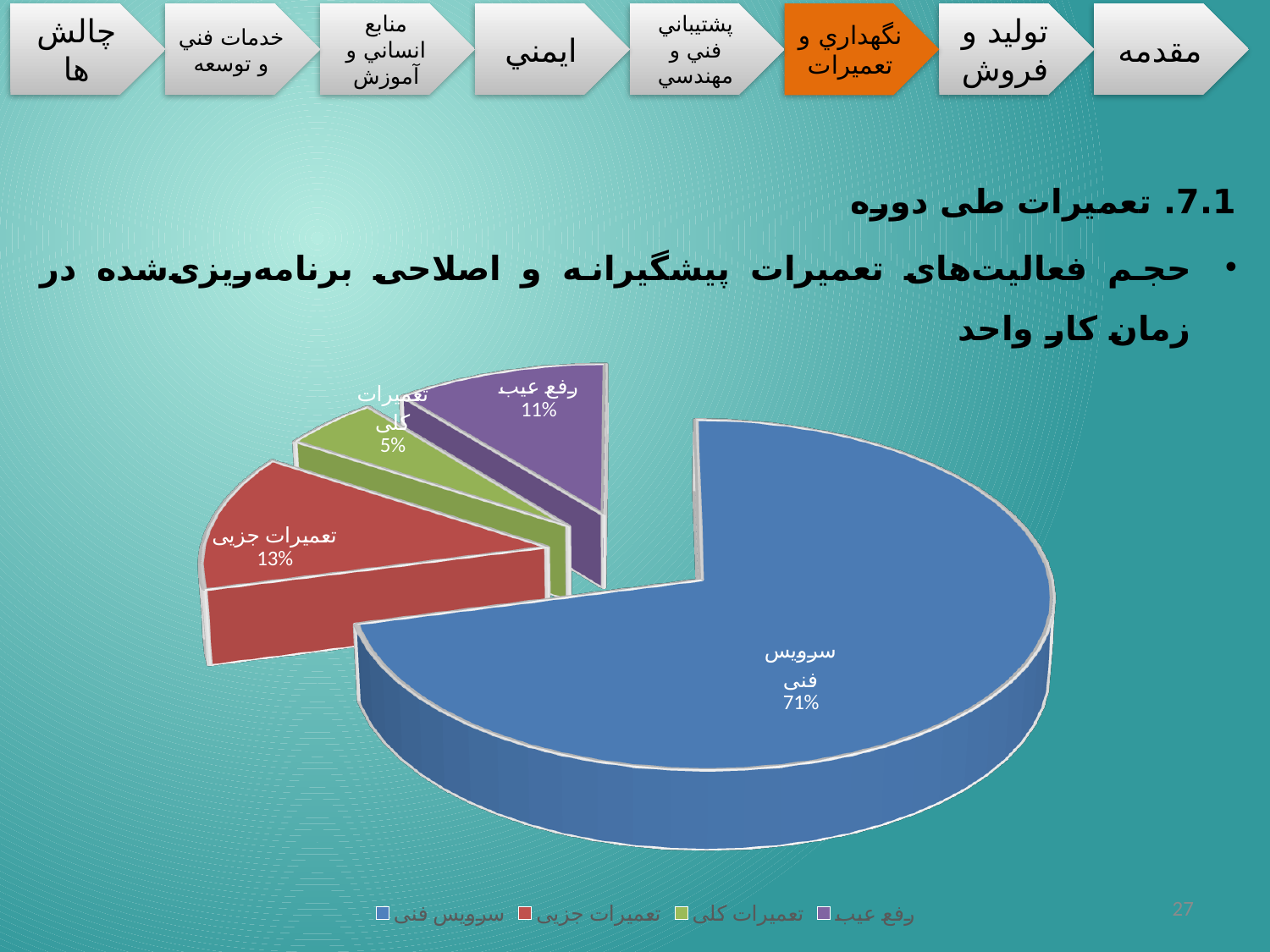
What share of the pie does تعمیرات کلی have? 5% What colour is the slice for رفع عیب? purple Which slice of the pie is the largest? سرویس فنی What kind of chart is shown on the slide? pie chart How many entries does the legend list? 4 How many slices does the pie chart have? 4 What share of the pie does سرویس فنی have? 71% What is the difference in percentage points between the share for سرویس فنی and the share for تعمیرات جزیی? 58 Which is larger, the share for تعمیرات جزیی or the share for رفع عیب? تعمیرات جزیی What share of the pie does تعمیرات جزیی have? 13% Which slice of the pie is the smallest? تعمیرات کلی